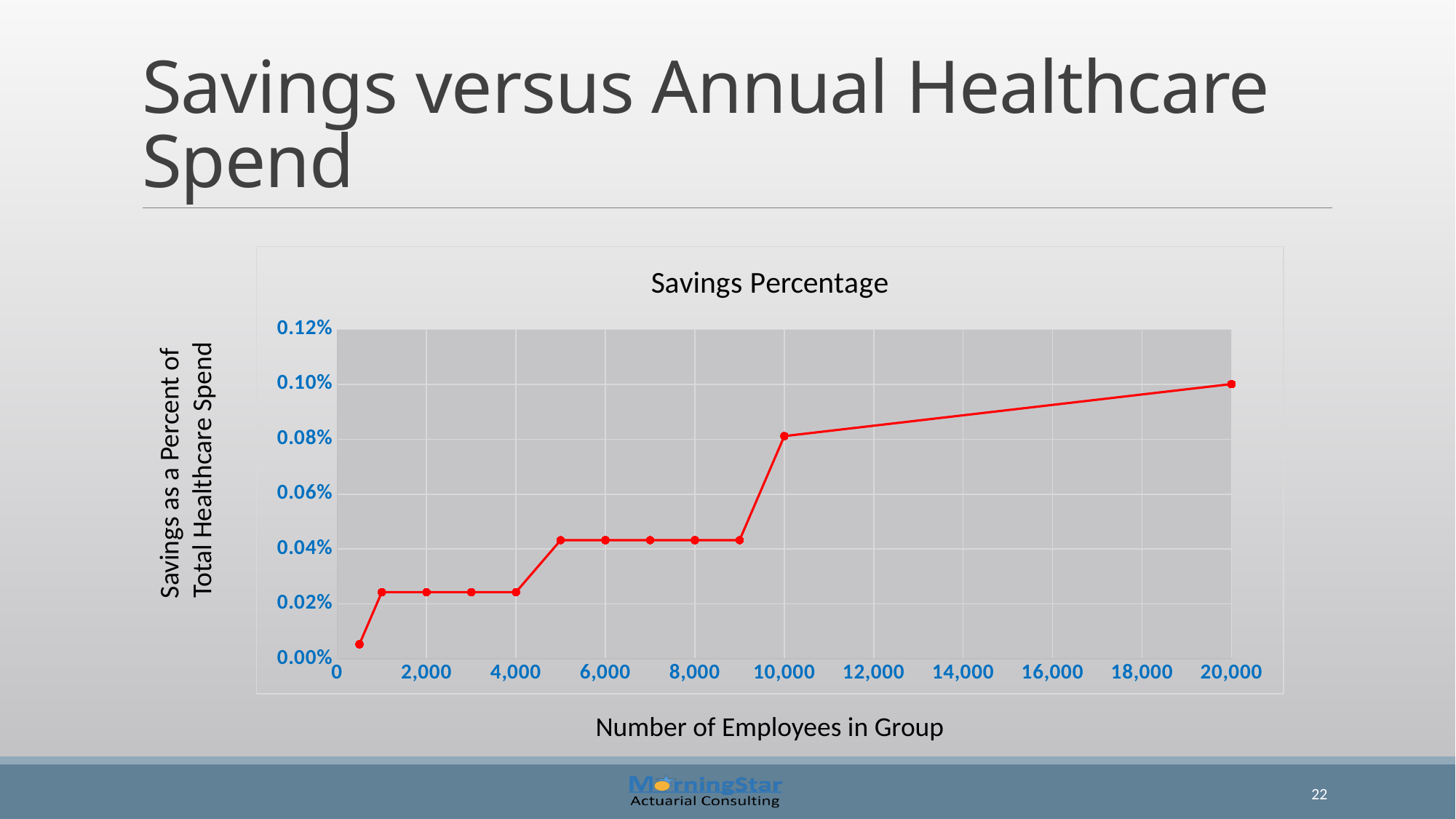
Which has a higher savings percentage: a group of 5,000 employees or a group of 2,000 employees? 5,000 employees What kind of chart is shown on the slide? line chart Do the savings percentage values generally rise or fall as the number of employees in the group increases? rise Is the savings percentage for a group of 4,000 employees greater or less than 0.04%? less How many data points are plotted on the line? 12 What is the label of the x axis of the chart? Number of Employees in Group Is the savings percentage for a group of 10,000 employees greater or less than 0.06%? greater Is the savings percentage for a group of 8,000 employees greater or less than 0.06%? less What is the title of the chart? Savings Percentage Which has a higher savings percentage: a group of 10,000 employees or a group of 20,000 employees? 20,000 employees At which number of employees in the group is the savings percentage highest? 20,000